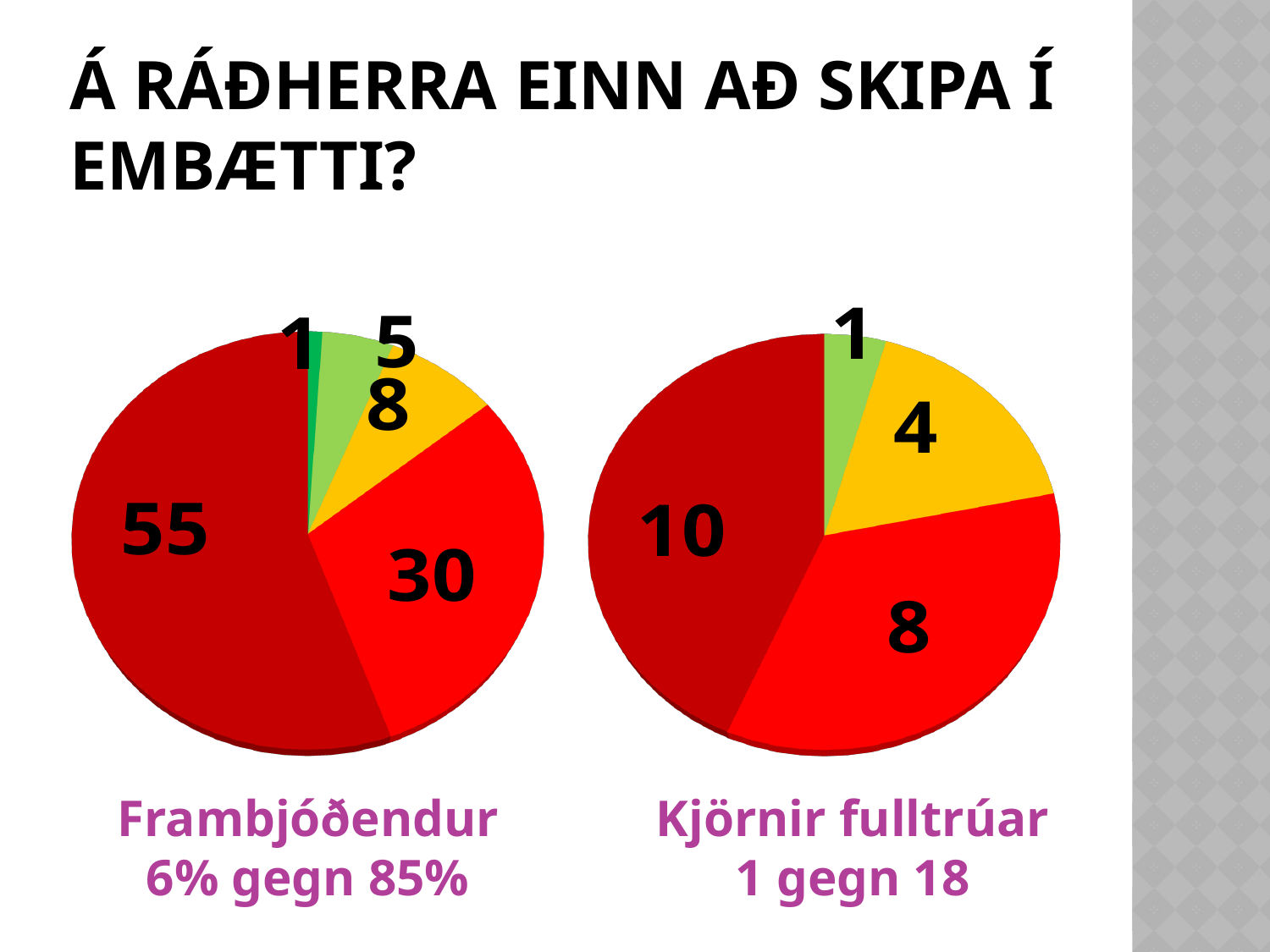
How many slices does the right pie chart (Kjörnir fulltrúar) have? 4 What kind of chart is the left chart labelled Frambjóðendur? pie chart In the right pie chart (Kjörnir fulltrúar), what is the value of the largest slice? 10 In the left pie chart (Frambjóðendur), what value is shown on the yellow slice? 8 How many slices does the left pie chart (Frambjóðendur) have? 5 In the left pie chart (Frambjóðendur), what is the value of the smallest slice? 1 In the right pie chart (Kjörnir fulltrúar), what value is shown on the yellow slice? 4 In the left pie chart (Frambjóðendur), what is the value of the largest slice? 55 In the right pie chart (Kjörnir fulltrúar), which slice is larger, the bright red slice or the yellow slice? the bright red slice What caption appears below the left pie chart? Frambjóðendur 6% gegn 85% What is the total of all slice values in the right pie chart (Kjörnir fulltrúar)? 23 In the left pie chart (Frambjóðendur), what is the difference between the dark red slice (55) and the bright red slice (30)? 25